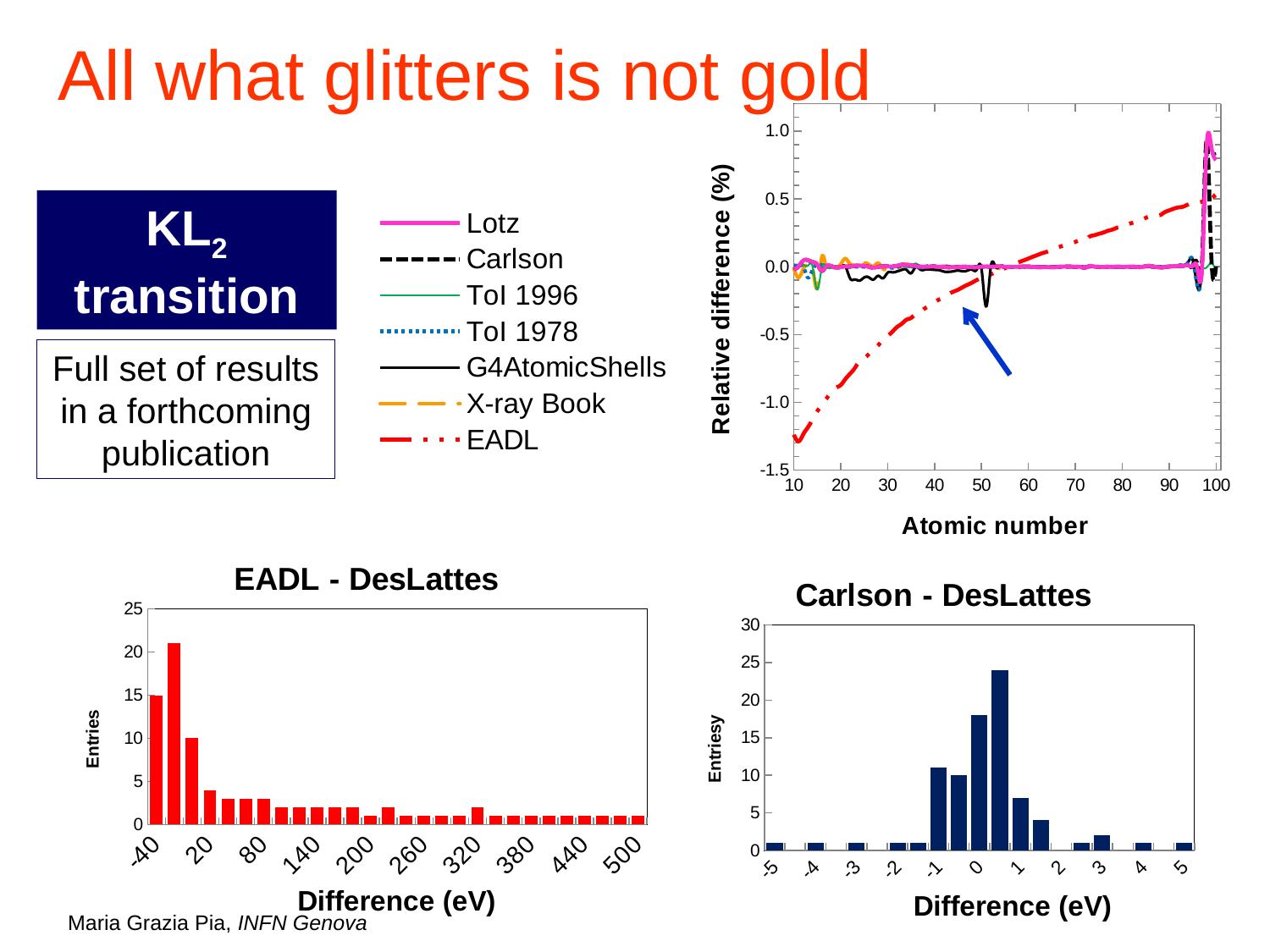
What kind of chart is the top-right chart with 'Atomic number' on the x axis? line chart In the 'Carlson - DesLattes' chart, is the value for 1 greater or less than 10? less What kind of chart is 'EADL - DesLattes'? bar chart In the top-right line chart, is the EADL value at atomic number 10 greater or less than -1.0? less In the 'EADL - DesLattes' chart, do the bar heights generally rise or fall as the difference increases along the x axis? fall How many series does the legend of the top-right line chart list? 7 In the 'Carlson - DesLattes' chart, which is larger, the bar at 0 or the bar at 1? 0 In the 'Carlson - DesLattes' chart, is the tallest bar greater or less than 20? greater What is the x-axis label of the 'Carlson - DesLattes' chart? Difference (eV) In the top-right line chart, does the EADL series rise or fall as atomic number increases? rise